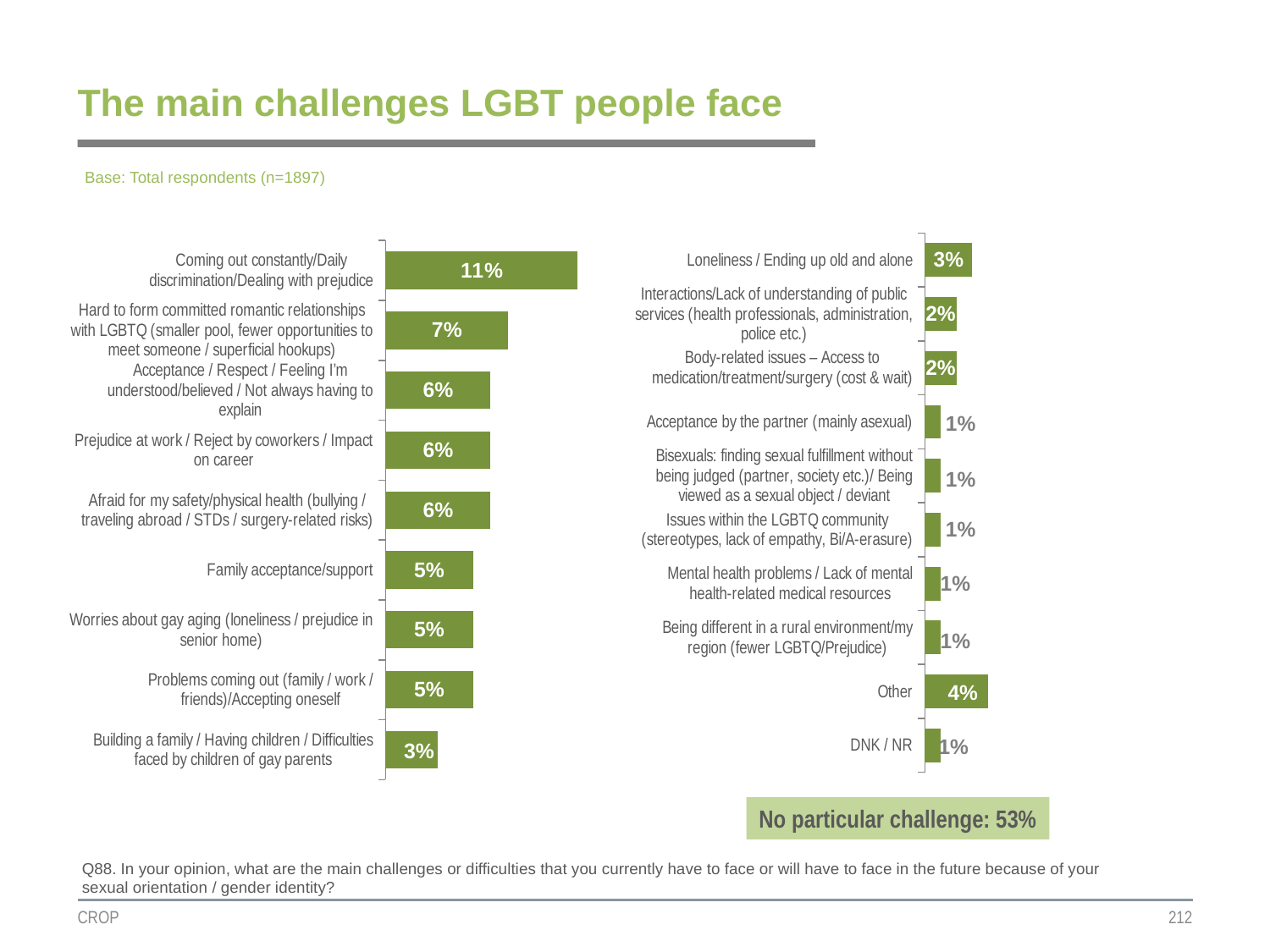
In the right chart, what is the value for Other? 4% In the left chart, which category has the highest value? Coming out constantly/Daily discrimination/Dealing with prejudice How many categories are shown in the right chart? 10 In the right chart, which category has the highest value? Other In the left chart, which category has the lowest value? Building a family / Having children / Difficulties faced by children of gay parents In the left chart, what is the value for Coming out constantly/Daily discrimination/Dealing with prejudice? 11% In the left chart, what is the difference between the value for Coming out constantly/Daily discrimination/Dealing with prejudice and the value for Hard to form committed romantic relationships with LGBTQ? 4% How many categories are shown in the left chart? 9 In the left chart, what is the value for Family acceptance/support? 5% What type of chart is used on this slide? Bar chart In the right chart, which is larger: the value for Loneliness / Ending up old and alone or the value for Acceptance by the partner (mainly asexual)? Loneliness / Ending up old and alone In the right chart, what is the value for Loneliness / Ending up old and alone? 3%